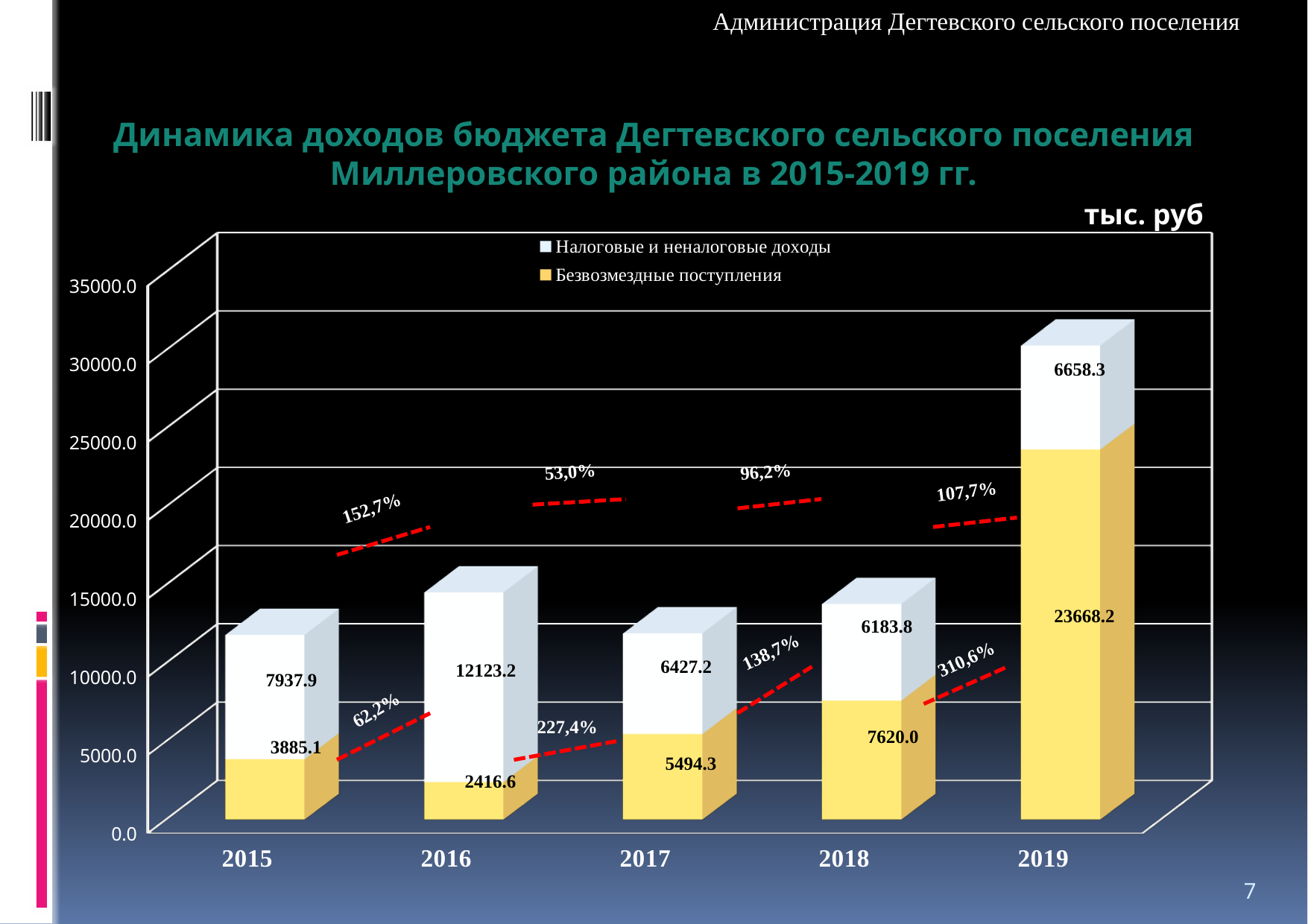
What is the difference between Безвозмездные поступления in 2018 and in 2017? 2125.7 In which year is Безвозмездные поступления the lowest? 2016 How many years are shown on the x axis? 5 What is the total of the stacked bar for 2015? 11823.0 Which is larger in 2018: Налоговые и неналоговые доходы or Безвозмездные поступления? Безвозмездные поступления What is the value of Безвозмездные поступления in 2017? 5494.3 What unit of measurement is indicated above the chart? тыс. руб What is the value of Налоговые и неналоговые доходы in 2016? 12123.2 What is the value of Безвозмездные поступления in 2019? 23668.2 How many series does the legend list? 2 In which year is Безвозмездные поступления the highest? 2019 What type of chart is shown on the slide? Stacked bar chart